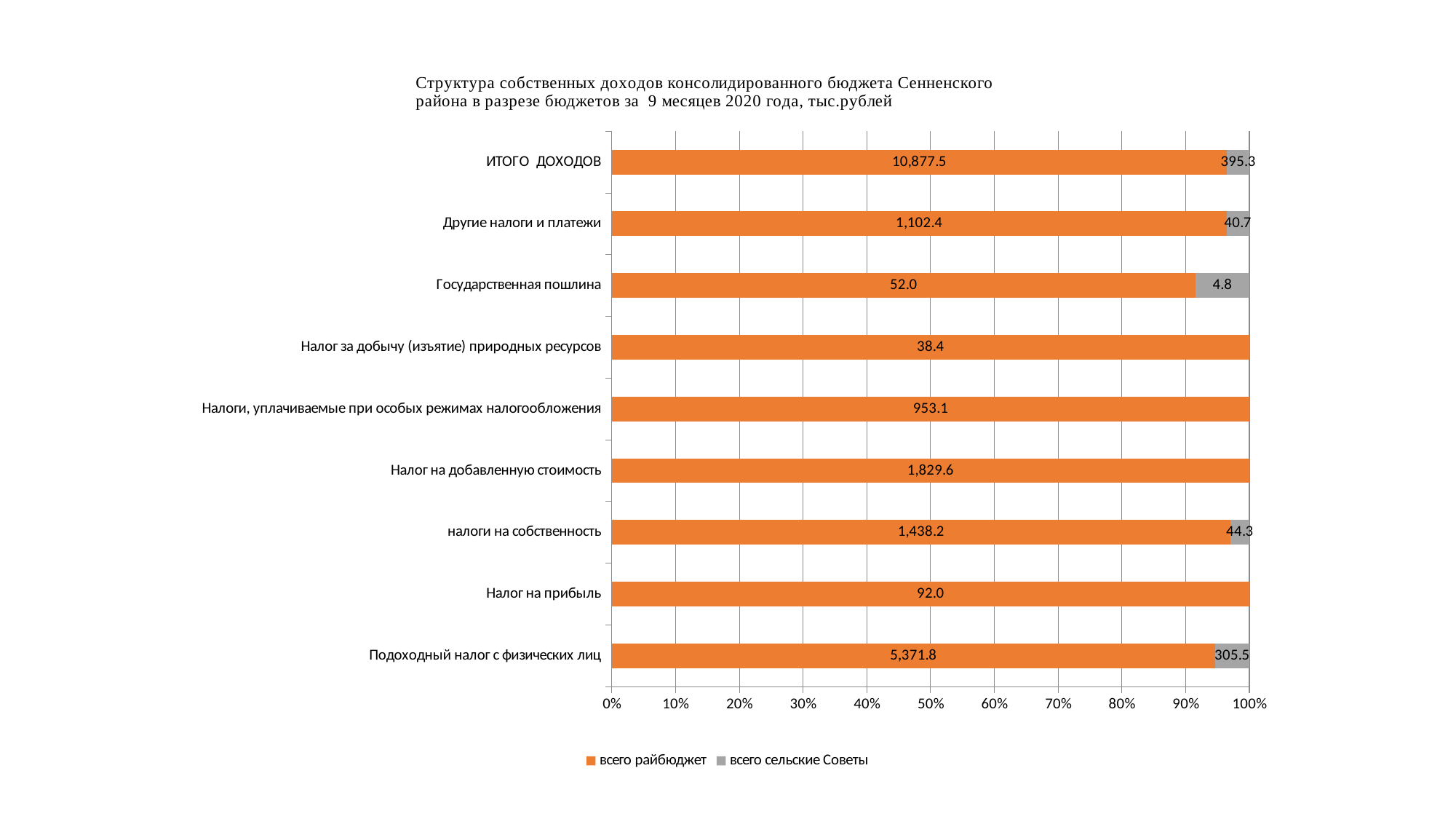
How many series does the legend list? 2 What type of chart is shown on the slide? bar chart Excluding ИТОГО ДОХОДОВ, which category has the highest всего райбюджет value? Подоходный налог с физических лиц What is the difference between the всего райбюджет values for ИТОГО ДОХОДОВ and Подоходный налог с физических лиц? 5,505.7 What is the value of всего райбюджет for ИТОГО ДОХОДОВ? 10,877.5 What is the value of всего сельские Советы for Подоходный налог с физических лиц? 305.5 What is the total of the two series for Государственная пошлина? 56.8 Which category has the lowest всего райбюджет value? Налог за добычу (изъятие) природных ресурсов What is the value of всего сельские Советы for Государственная пошлина? 4.8 What is the value of всего райбюджет for Налог на добавленную стоимость? 1,829.6 How many categories are shown on the vertical axis? 9 Is the share of всего райбюджет for Государственная пошлина greater or less than 90%? greater